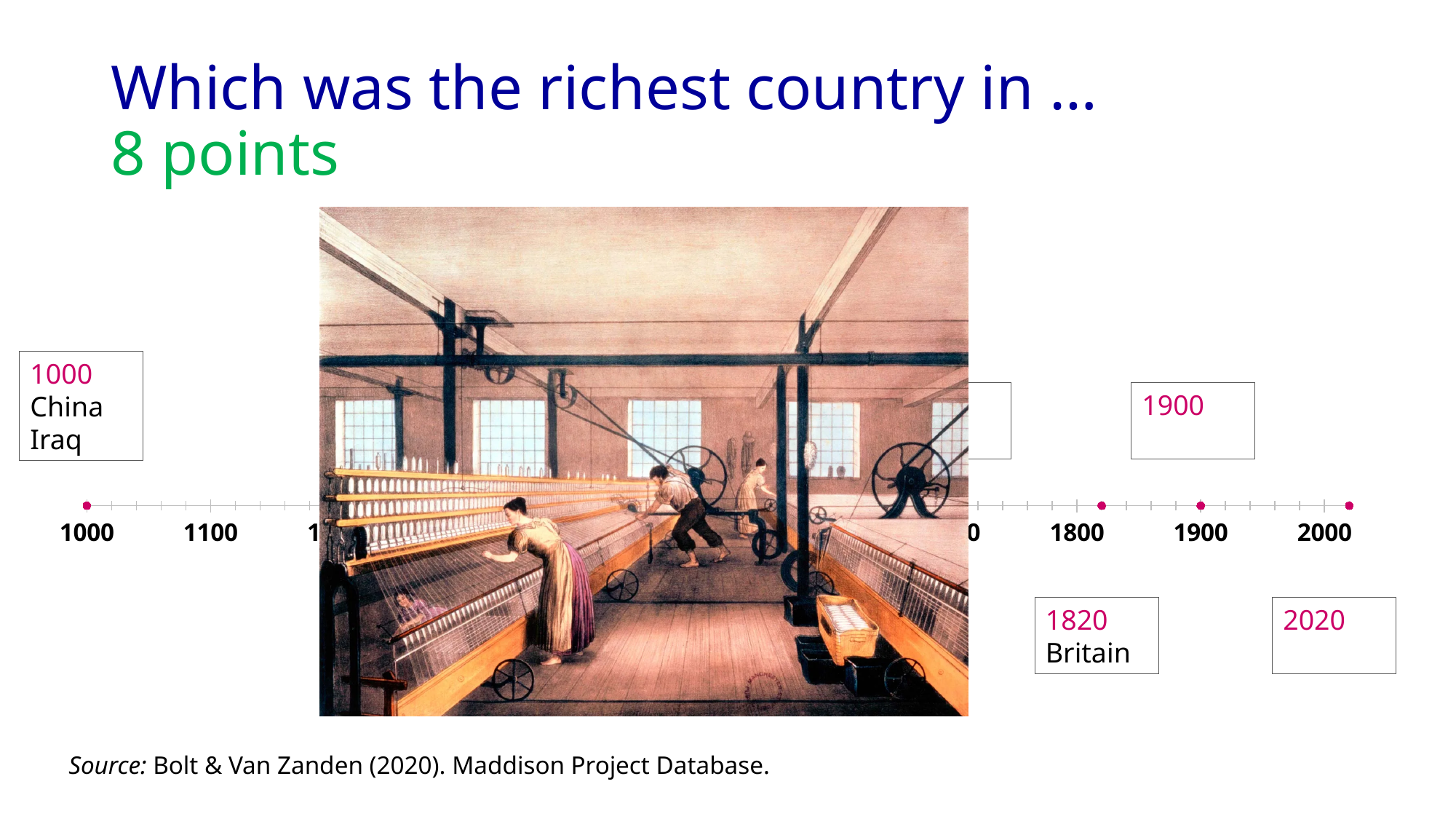
How many years apart are the 1820 and 1900 markers on the timeline? 80 What is the latest year labelled on the timeline axis? 2000 Which two callout boxes on the timeline have no country filled in? 1900 and 2020 What kind of chart is shown on the slide? A timeline How many highlighted marker points are visible on the timeline? 4 Which year on the timeline is labelled with Britain? 1820 What is the source cited for the timeline? Bolt & Van Zanden (2020). Maddison Project Database. According to the timeline, which countries are listed as the richest in the year 1000? China and Iraq According to the timeline, which country is listed as the richest in 1820? Britain What is the earliest year labelled on the timeline axis? 1000 Is the marker for Britain on the timeline placed before or after 1800? after What is the latest year shown in a callout box on the timeline? 2020